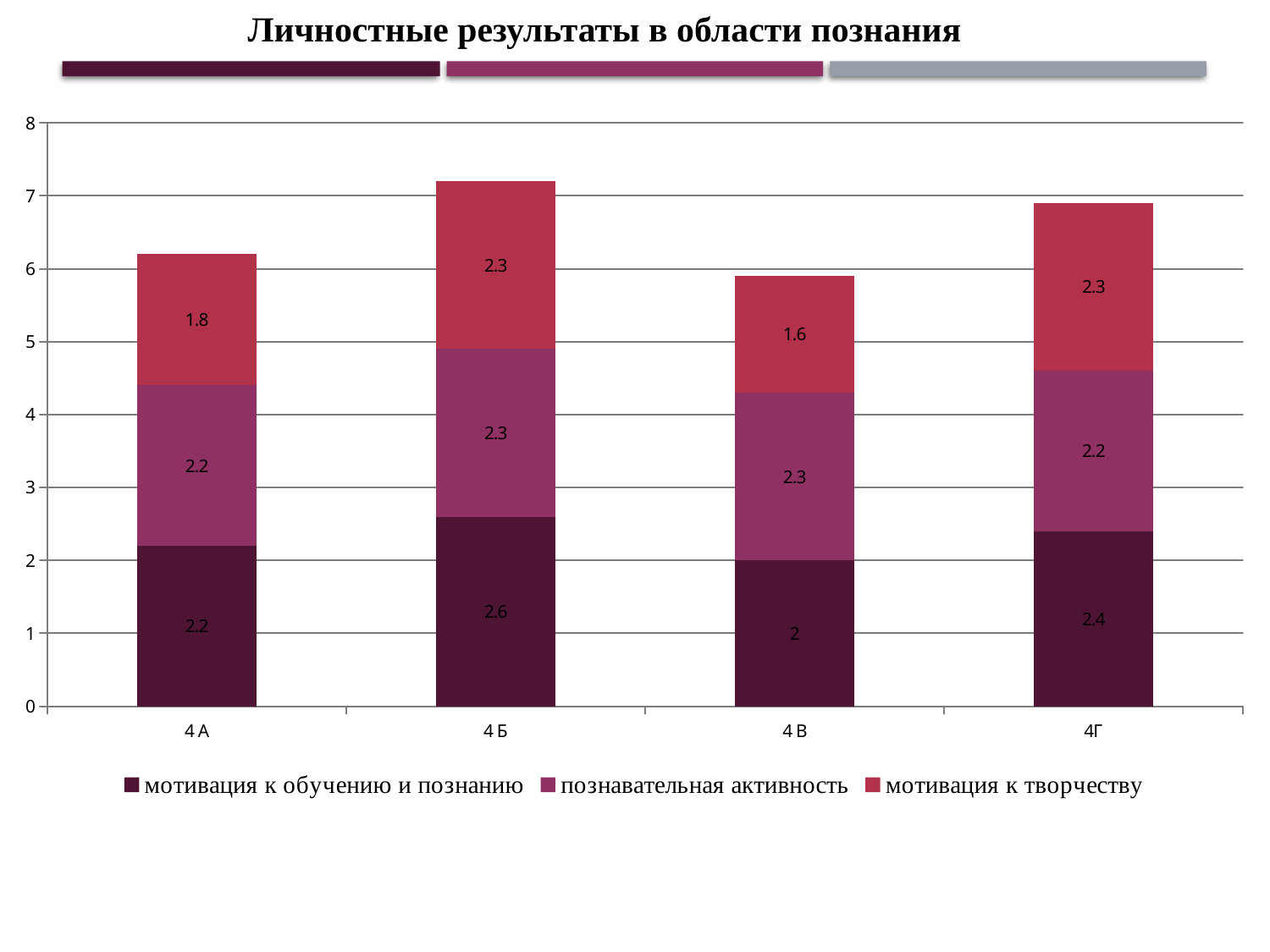
Which is larger: мотивация к обучению и познанию for 4 Г or for 4 В? 4 Г Which category has the highest value for мотивация к обучению и познанию? 4 Б What is the value of мотивация к обучению и познанию for 4 Б? 2.6 What is the total of the stacked bar for 4 Б? 7.2 Which category has the lowest value for мотивация к творчеству? 4 В What is the total of the stacked bar for 4 В? 5.9 What is the value of познавательная активность for 4 Г? 2.2 What is the value of мотивация к творчеству for 4 В? 1.6 How many series does the legend list? 3 What is the difference between the мотивация к творчеству values for 4 Б and 4 А? 0.5 What kind of chart is shown on the slide? Stacked bar chart How many categories are shown on the x axis? 4